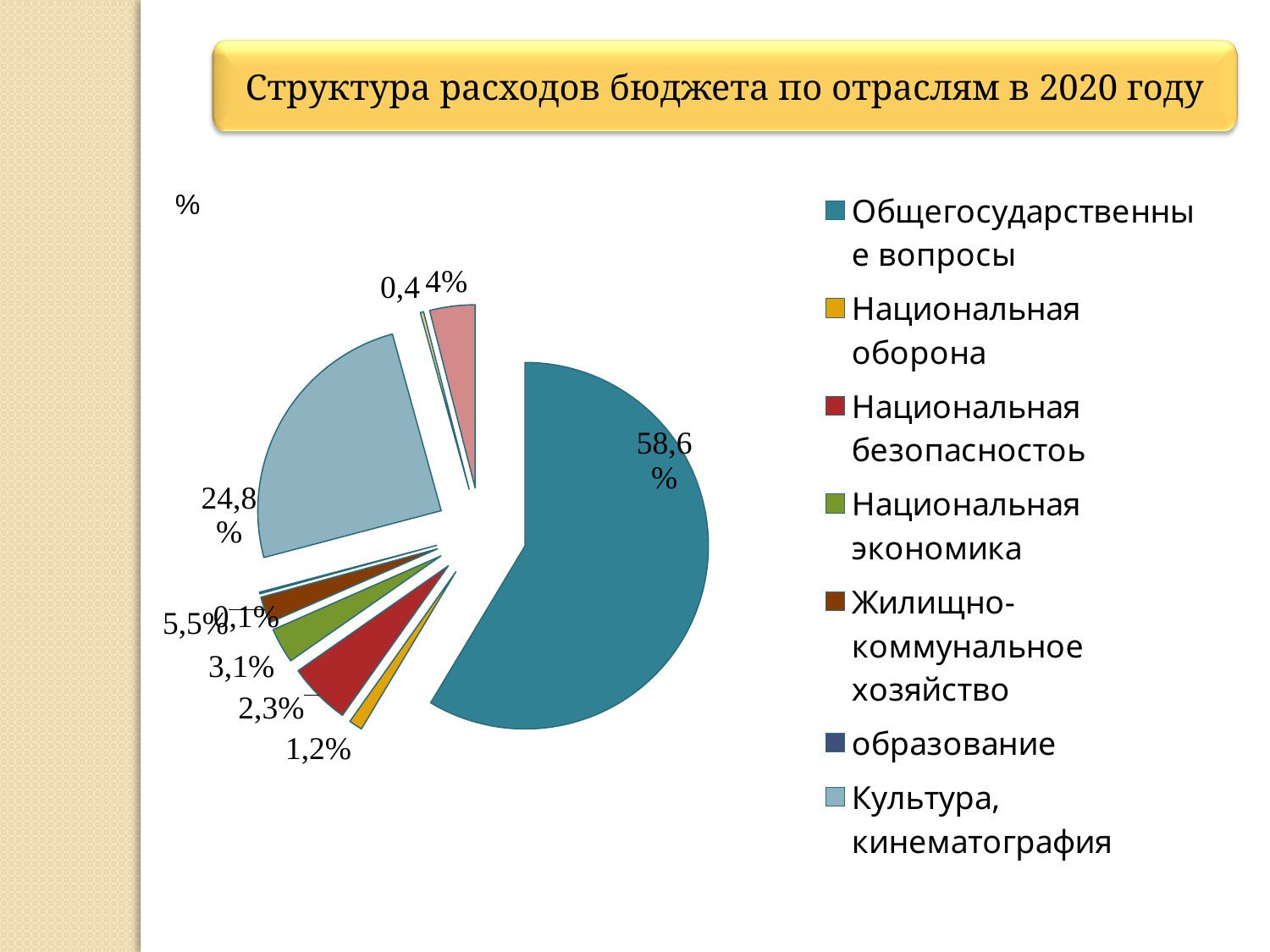
What share of the pie does Национальная экономика have? 3,1% What share of the pie does Культура, кинематография have? 24,8% What share of the pie does Национальная оборона have? 1,2% What kind of chart is shown on the slide? pie chart What is the difference between the shares for Общегосударственные вопросы and Культура, кинематография? 33,8% What is the title of the chart? Структура расходов бюджета по отраслям в 2020 году Which category has the largest share of the pie? Общегосударственные вопросы How many entries does the legend list? 7 What share of the pie does Общегосударственные вопросы have? 58,6%